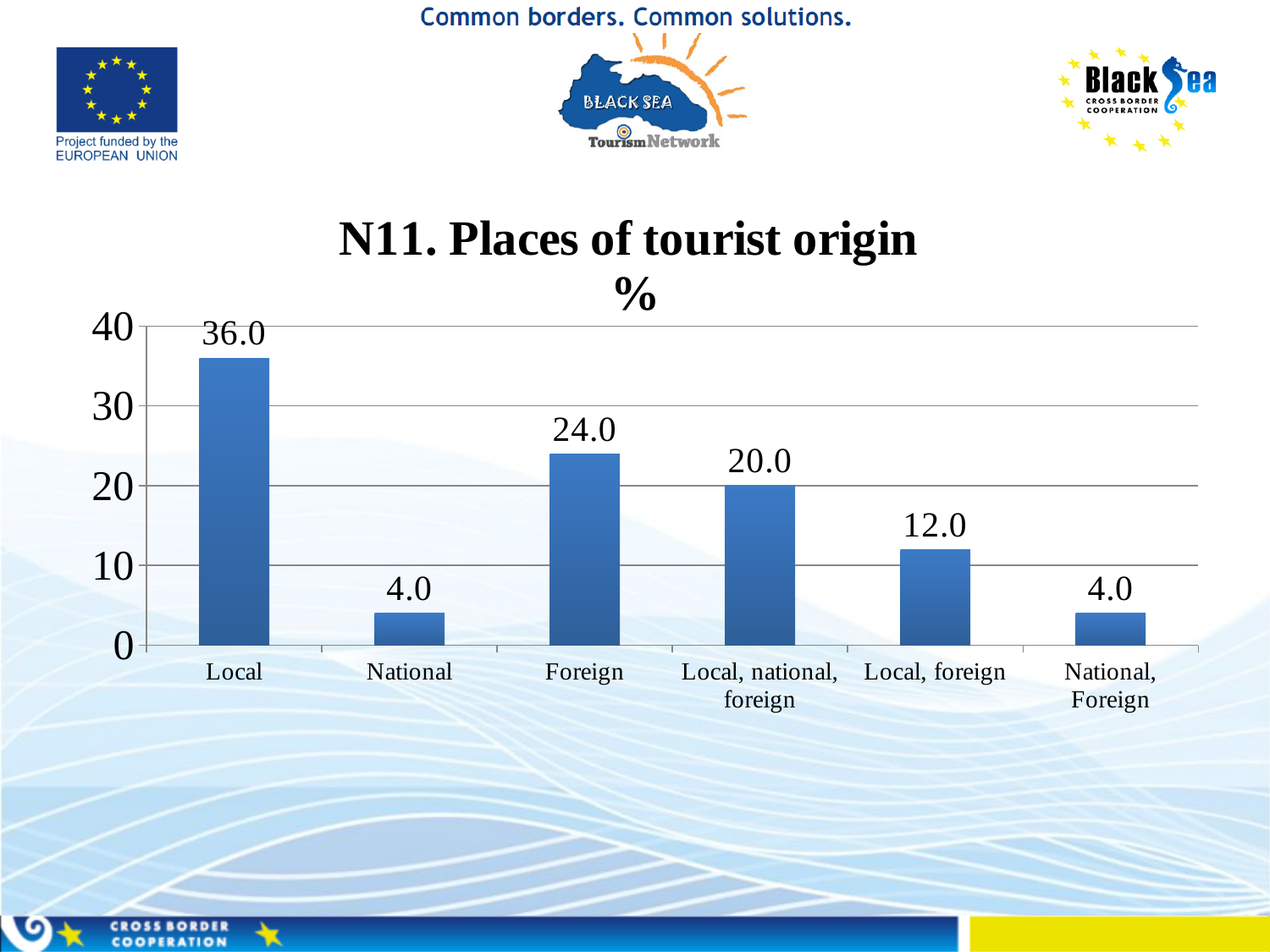
What is the difference between the values for Local, national, foreign and Local, foreign? 8.0 Which category has the highest value? Local What is the difference between the values for Local and Foreign? 12.0 What kind of chart is shown on the slide? bar chart Which is larger, the value for Foreign or the value for Local, national, foreign? Foreign What is the value for Local? 36.0 Is the value for Local greater or less than 30? greater How many categories are shown on the x axis? 6 What is the value for Local, national, foreign? 20.0 What is the value for Local, foreign? 12.0 What is the value for Foreign? 24.0 What is the title of the chart? N11. Places of tourist origin %